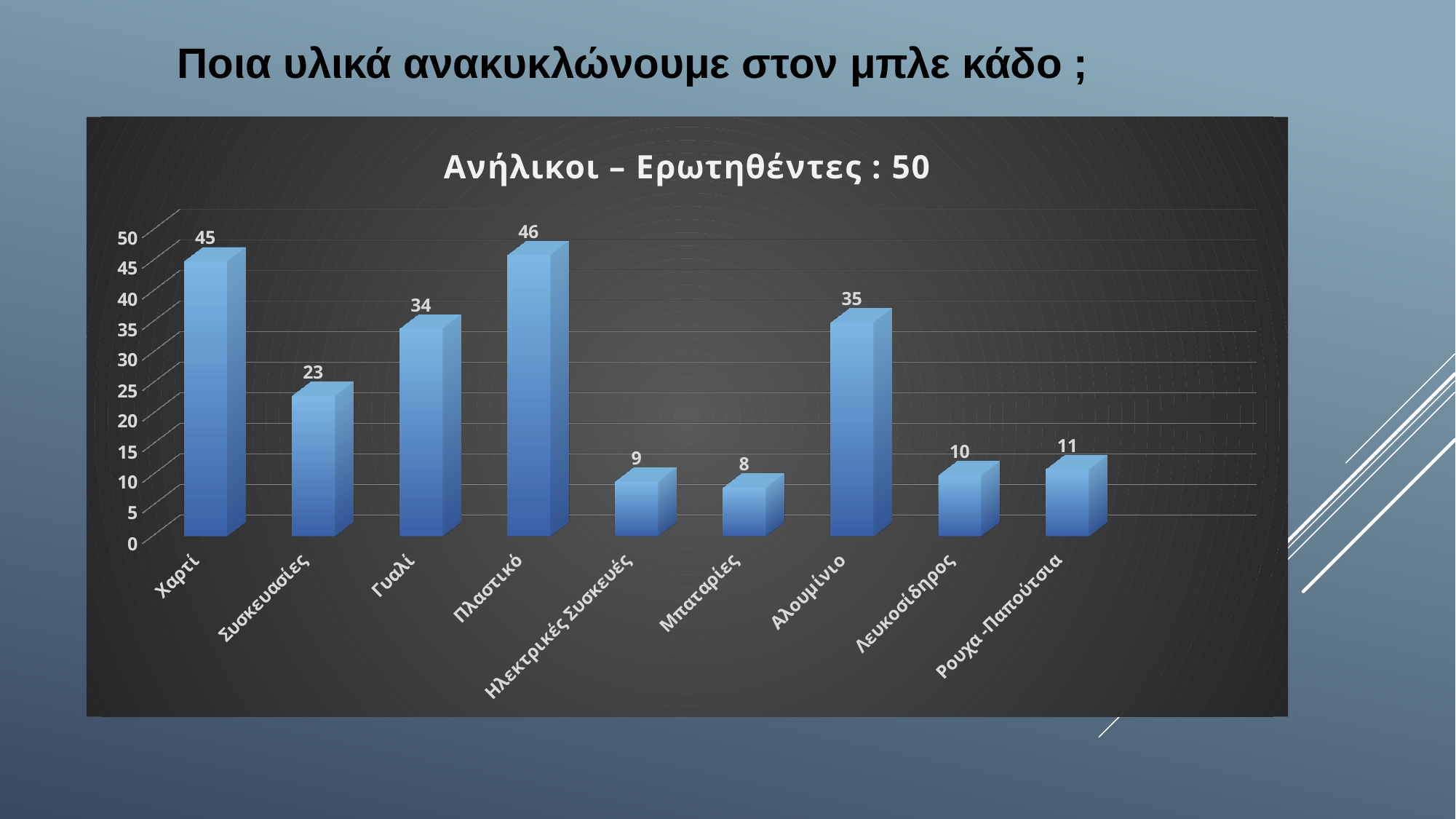
How many categories are shown on the x axis? 9 Which is larger, the value for Αλουμίνιο or the value for Γυαλί? Αλουμίνιο What is the title of the chart? Ανήλικοι – Ερωτηθέντες : 50 What is the value for Χαρτί? 45 What kind of chart is shown on the slide? Bar chart Which category has the lowest value? Μπαταρίες Which category has the highest value? Πλαστικό What is the value for Μπαταρίες? 8 What is the difference between the values for Λευκοσίδηρος and Ηλεκτρικές Συσκευές? 1 What is the difference between the values for Πλαστικό and Γυαλί? 12 What is the value for Ρουχα -Παπούτσια? 11 What is the value for Συσκευασίες? 23